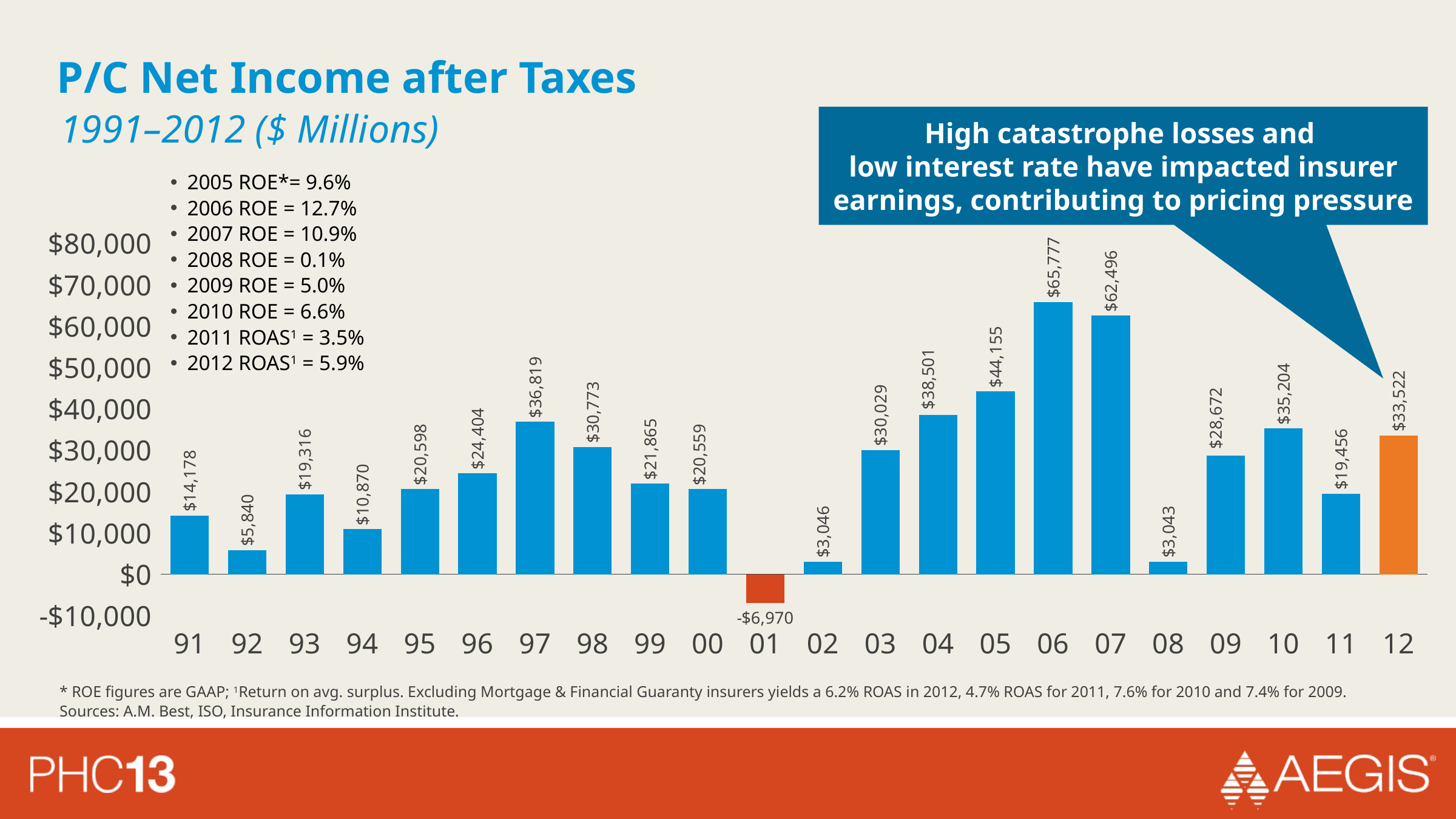
Which year has the highest net income after taxes? 06 Which year has the lowest net income after taxes? 01 What is the value shown for 2001? -$6,970 How many years are plotted on the chart? 22 Which bar is coloured orange? 12 Do the values rise or fall from 2007 to 2008? Fall What is the value shown for 2012? $33,522 Which year has the larger value, 2004 or 2005? 05 What kind of chart is shown on the slide? Bar chart What is the difference between the values for 2011 and 2012? $14,066 What is the difference between the values for 2006 and 2007? $3,281 What is the P/C net income after taxes for 2006? $65,777